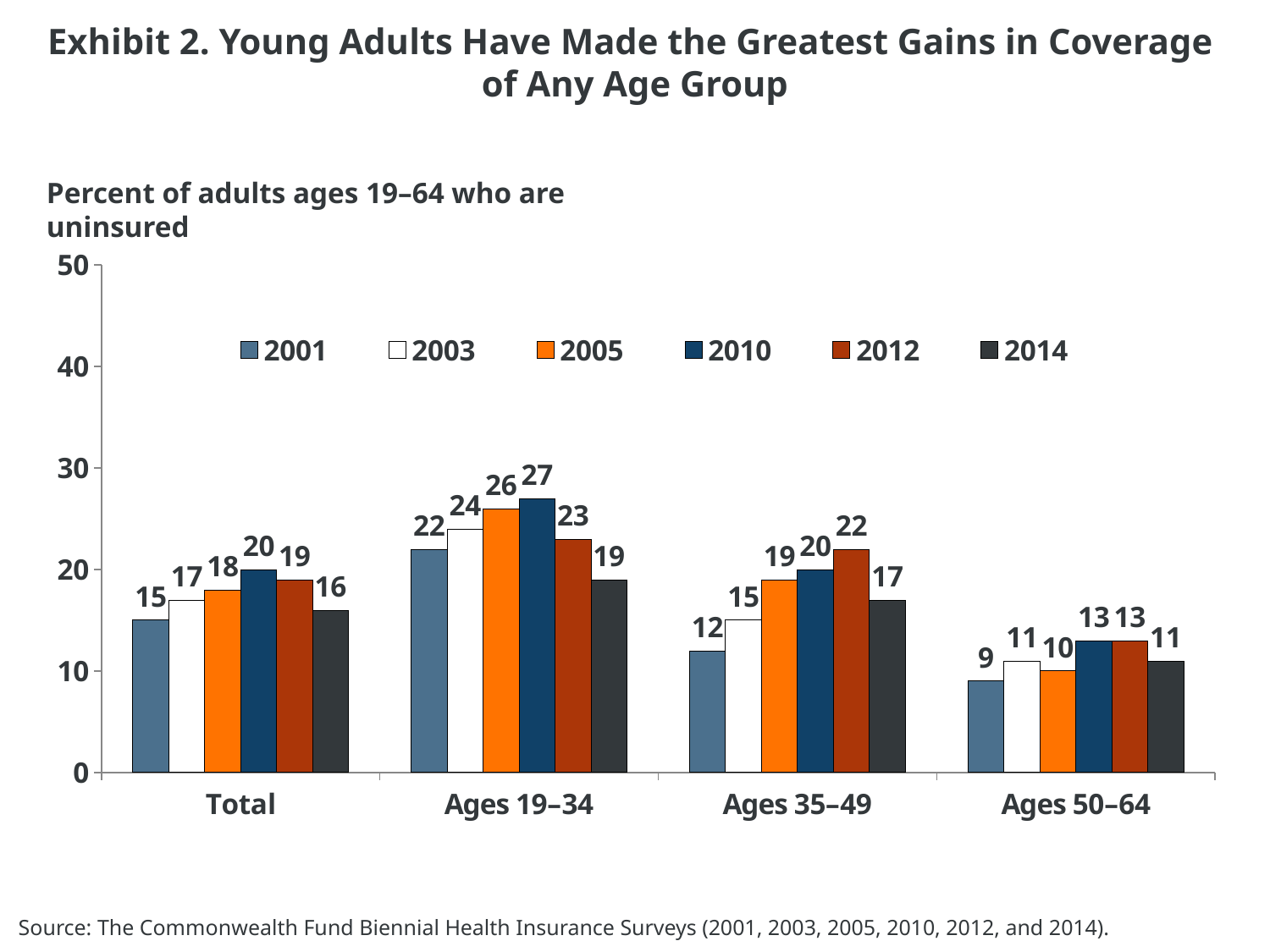
Which is larger for Ages 35–49: the 2003 value or the 2012 value? 2012 What is the value for Ages 19–34 in 2010? 27 Which age group has the lowest value in 2005? Ages 50–64 For Ages 35–49, do the values rise or fall from 2001 to 2012? rise Which age group has the highest value in 2012? Ages 19–34 What is the value for Ages 50–64 in 2001? 9 What is the value for Total in 2014? 16 What is the title of the chart? Exhibit 2. Young Adults Have Made the Greatest Gains in Coverage of Any Age Group How many series does the legend list? 6 What is the difference between the 2010 and 2014 values for Ages 19–34? 8 How many age group categories are shown on the x axis? 4 What kind of chart is shown? bar chart